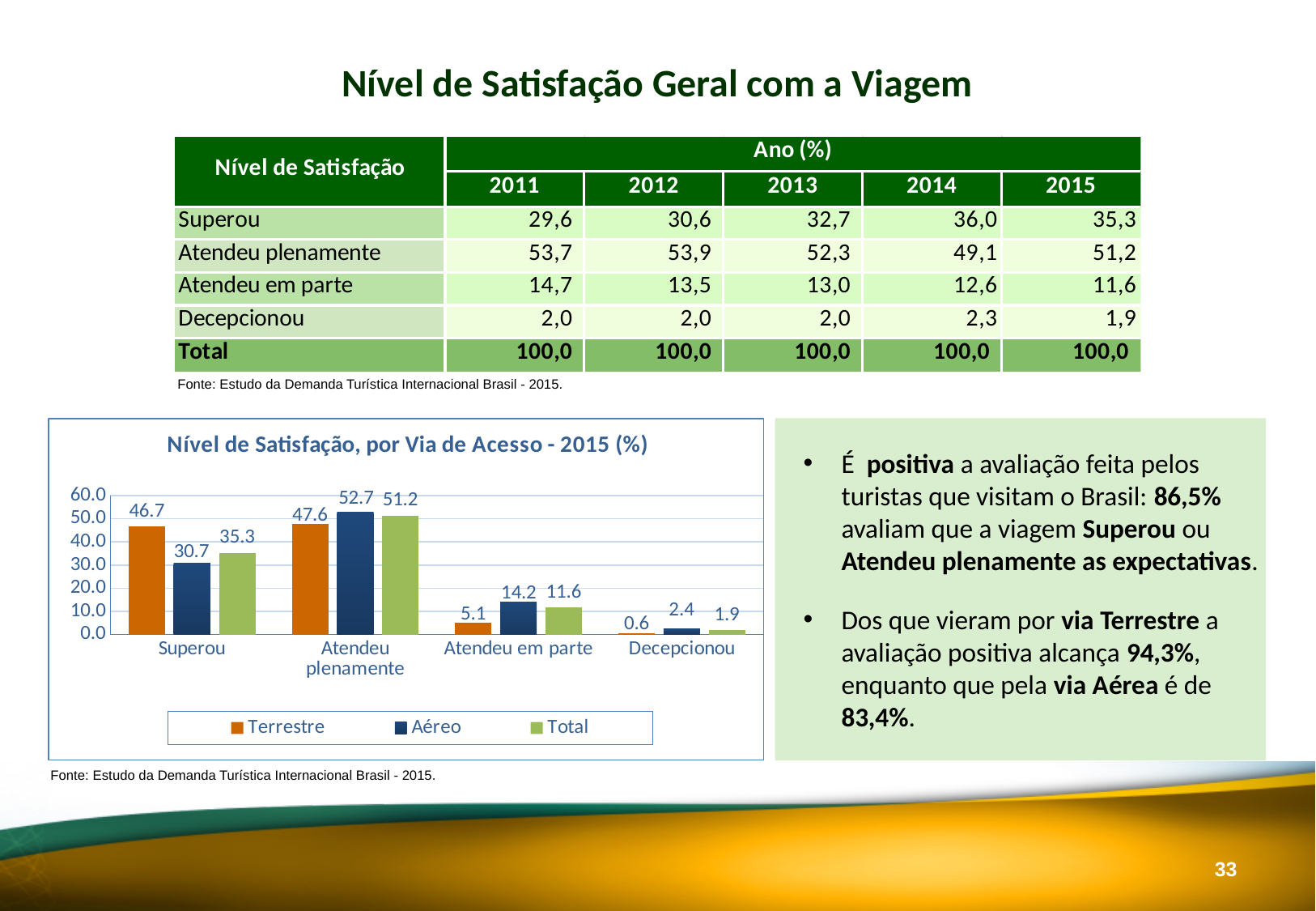
What is the Aéreo value for Atendeu plenamente in the chart? 52.7 What is the Terrestre value for Superou in the chart? 46.7 What type of chart is shown on the slide? Bar chart How many series does the chart legend list? 3 What is the Total value for Atendeu em parte in the chart? 11.6 What is the Terrestre value for Decepcionou in the chart? 0.6 Which category has the highest Aéreo value in the chart? Atendeu plenamente Which category has the lowest Total value in the chart? Decepcionou What is the difference between the Terrestre and Aéreo values for Superou? 16.0 For Atendeu em parte, which is larger: the Terrestre value or the Aéreo value? Aéreo How many categories are shown on the x axis of the chart? 4 Is the Aéreo value for Atendeu plenamente greater or less than 50.0? greater